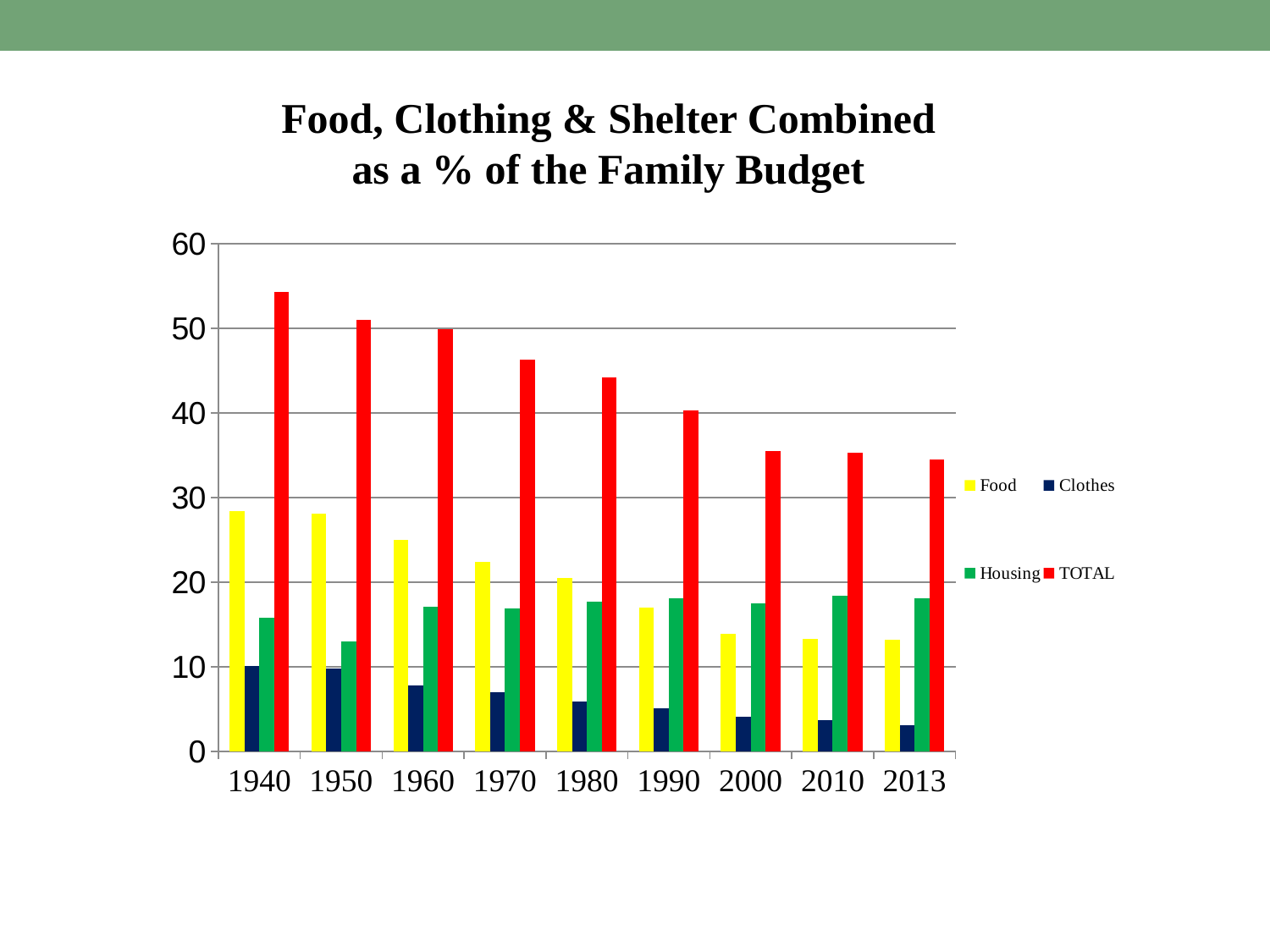
How many years are shown along the x axis? 9 How many series does the legend list? 4 Is the Food value for 1960 greater or less than 20? greater In 1940, which is larger: Food or Housing? Food In which year is the TOTAL bar highest? 1940 Does the TOTAL series rise or fall from 1940 to 2013? fall In which year is the Clothes bar lowest? 2013 What colour are the TOTAL bars? red Is the TOTAL value for 1940 greater or less than 50? greater What kind of chart is shown on the slide? bar chart Is the Clothes value for 1970 greater or less than 10? less In 2013, which is larger: Food or Housing? Housing